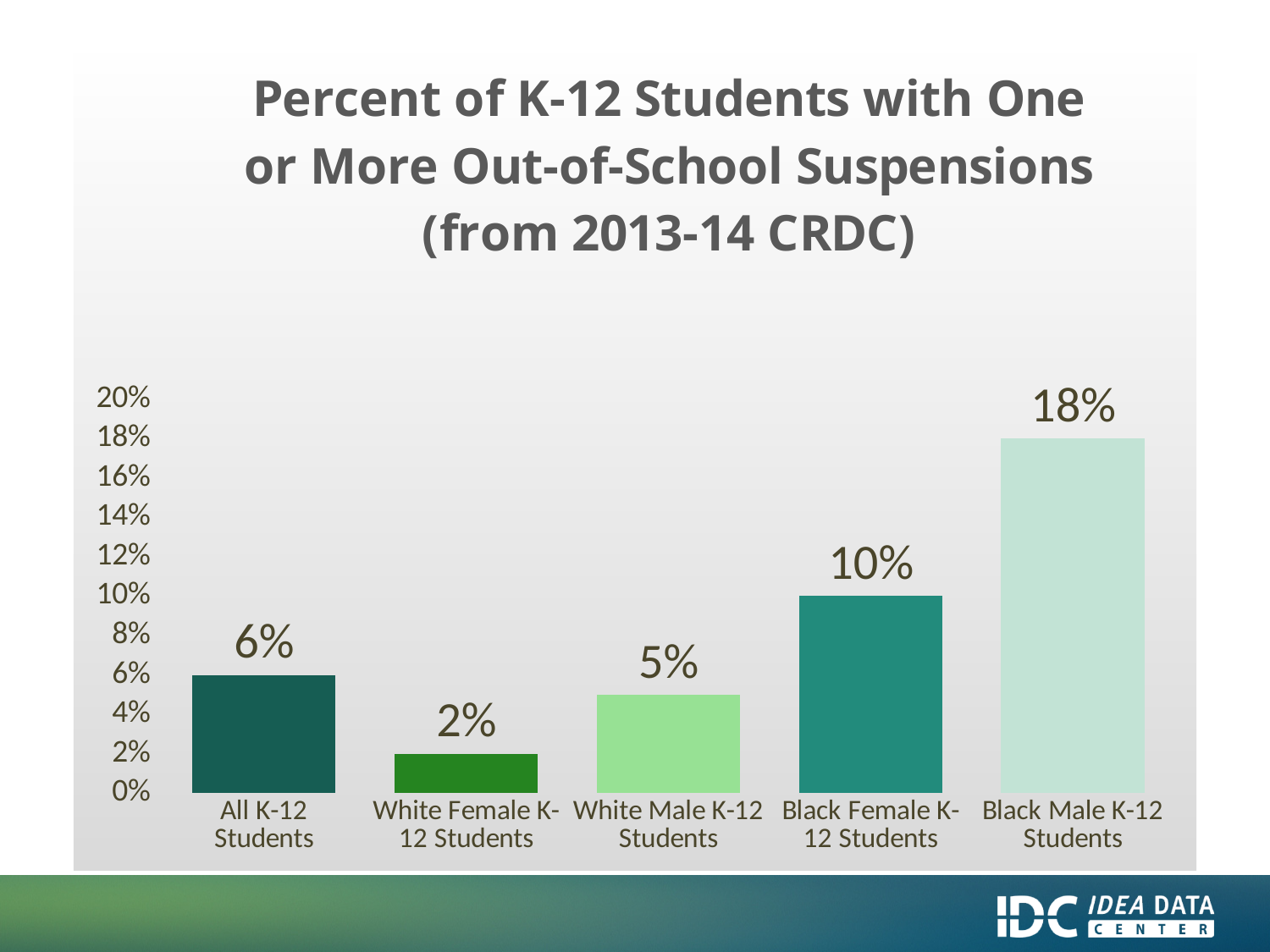
Is the value for Black Male K-12 Students greater or less than 16%? greater What percent of All K-12 Students had one or more out-of-school suspensions? 6% How many categories are shown on the chart? 5 Which category has the lowest percentage? White Female K-12 Students What is the difference in percentage points between Black Male K-12 Students and White Male K-12 Students? 13% What is the title of the chart? Percent of K-12 Students with One or More Out-of-School Suspensions (from 2013-14 CRDC) Which is larger, the value for All K-12 Students or the value for White Male K-12 Students? All K-12 Students What is the difference between the values for Black Female K-12 Students and White Female K-12 Students? 8% What kind of chart is shown on the slide? Bar chart What is the value shown for White Female K-12 Students? 2% What is the value shown for Black Female K-12 Students? 10% Which category has the highest percentage of students with one or more out-of-school suspensions? Black Male K-12 Students